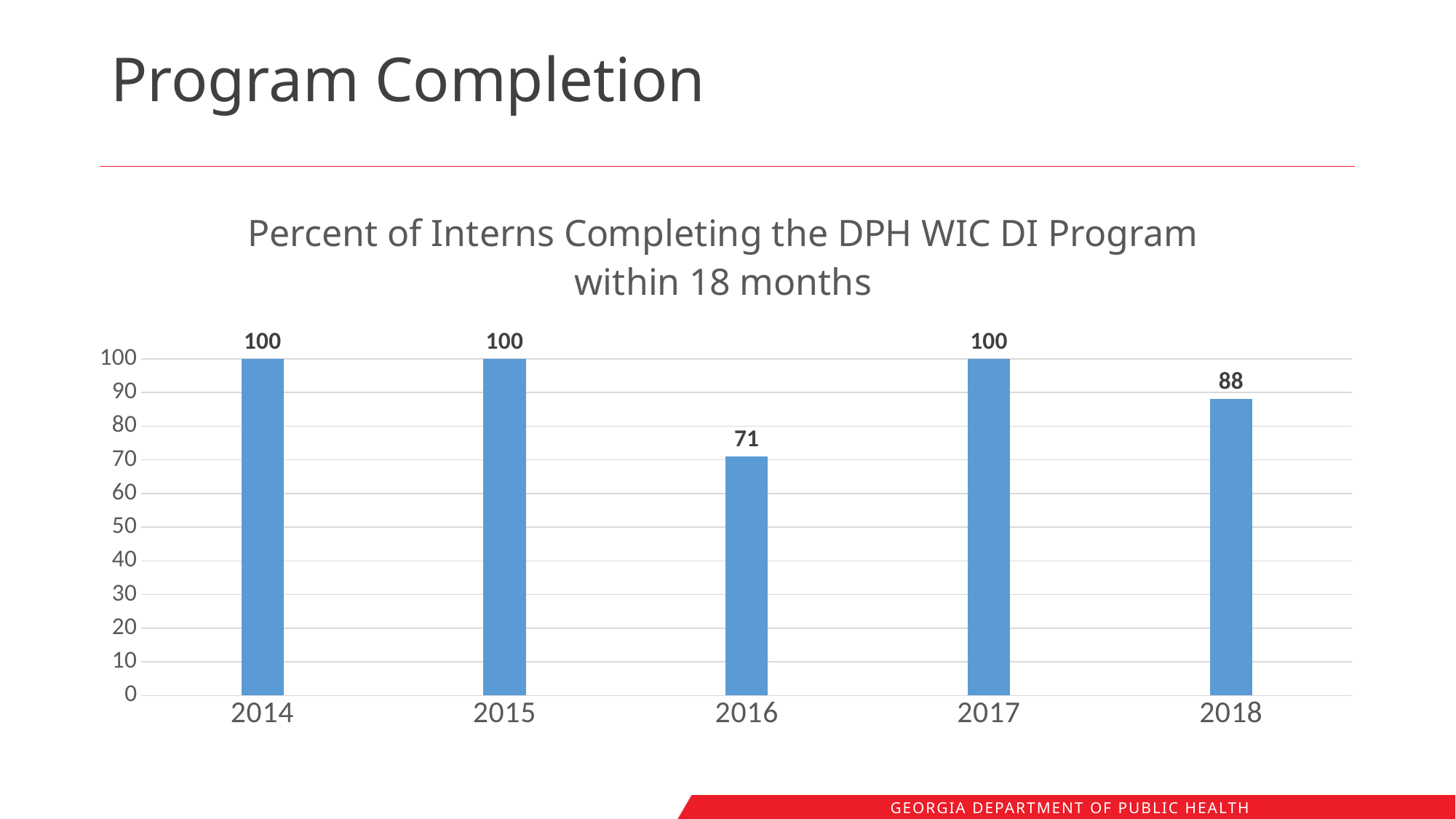
Which year has the lowest value? 2016 What kind of chart is shown on the slide? bar chart How many years are shown on the x axis? 5 Which is larger, the value for 2016 or the value for 2018? 2018 What is the value for 2018? 88 What is the title of the chart? Percent of Interns Completing the DPH WIC DI Program within 18 months What is the difference between the values for 2017 and 2018? 12 What is the difference between the values for 2018 and 2016? 17 How many years have a value of 100? 3 What is the value for 2016? 71 Is the value for 2016 greater or less than 80? less What is the value for 2014? 100